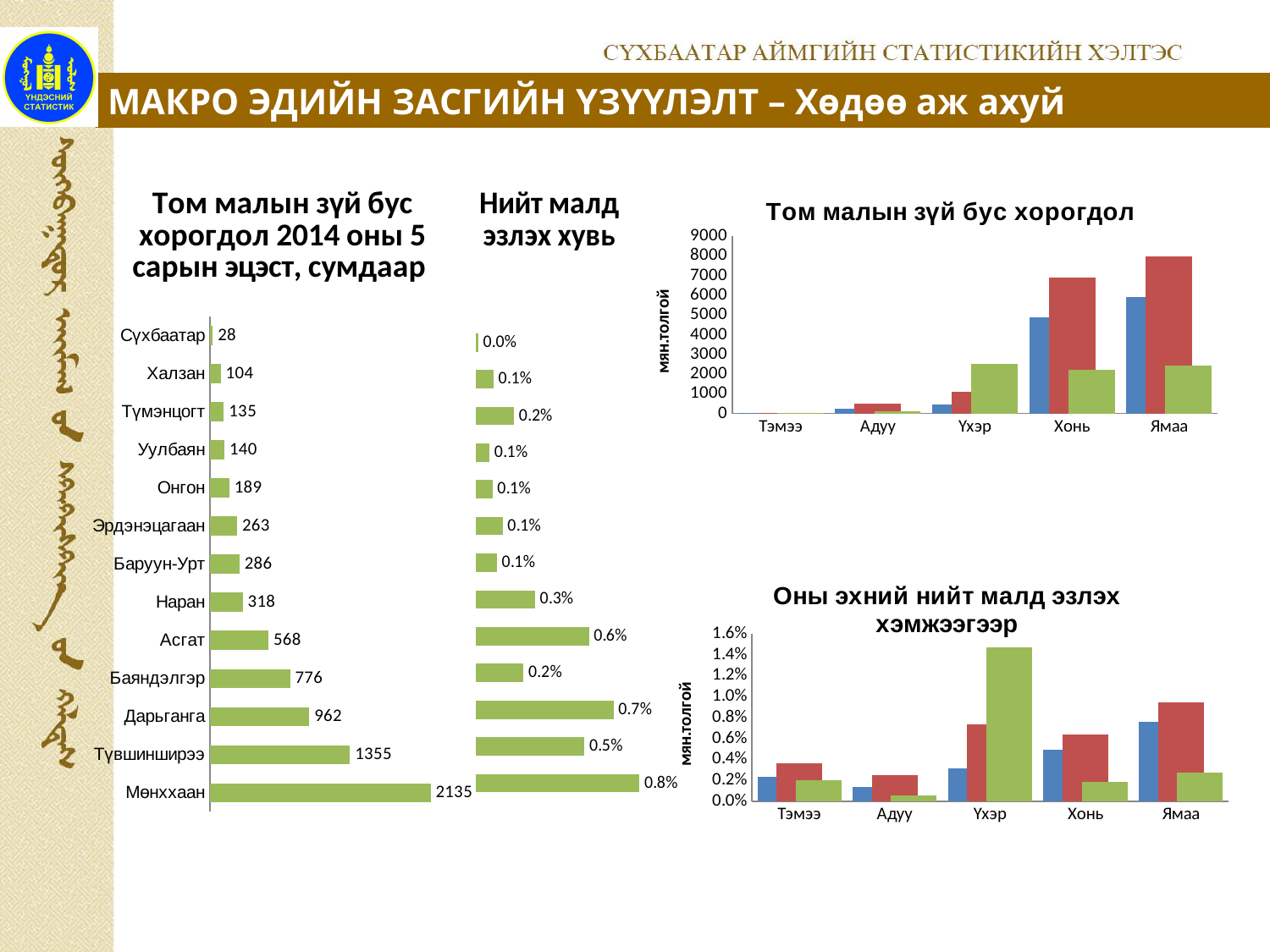
How many categories are shown in the chart 'Том малын зүй бус хорогдол 2014 оны 5 сарын эцэст, сумдаар'? 13 In the chart 'Том малын зүй бус хорогдол 2014 оны 5 сарын эцэст, сумдаар', what is the value for Мөнххаан? 2135 In the chart 'Том малын зүй бус хорогдол 2014 оны 5 сарын эцэст, сумдаар', what is the difference between Түвшинширээ and Баяндэлгэр? 579 In the chart 'Том малын зүй бус хорогдол 2014 оны 5 сарын эцэст, сумдаар', what is the value for Дарьганга? 962 How many categories are shown on the x axis of the bottom-right chart 'Оны эхний нийт малд эзлэх хэмжээгээр'? 5 In the chart 'Том малын зүй бус хорогдол 2014 оны 5 сарын эцэст, сумдаар', which is larger, Асгат or Наран? Асгат In the chart 'Том малын зүй бус хорогдол 2014 оны 5 сарын эцэст, сумдаар', which category has the highest value? Мөнххаан In the chart 'Нийт малд эзлэх хувь', what is the highest value shown? 0.8% In the top-right chart 'Том малын зүй бус хорогдол', is the red bar for Ямаа greater or less than 7000? greater In the chart 'Том малын зүй бус хорогдол 2014 оны 5 сарын эцэст, сумдаар', which category has the lowest value? Сүхбаатар What kind of chart is 'Том малын зүй бус хорогдол' in the top right of the slide? bar chart In the bottom-right chart 'Оны эхний нийт малд эзлэх хэмжээгээр', is the green bar for Үхэр greater or less than 1.2%? greater